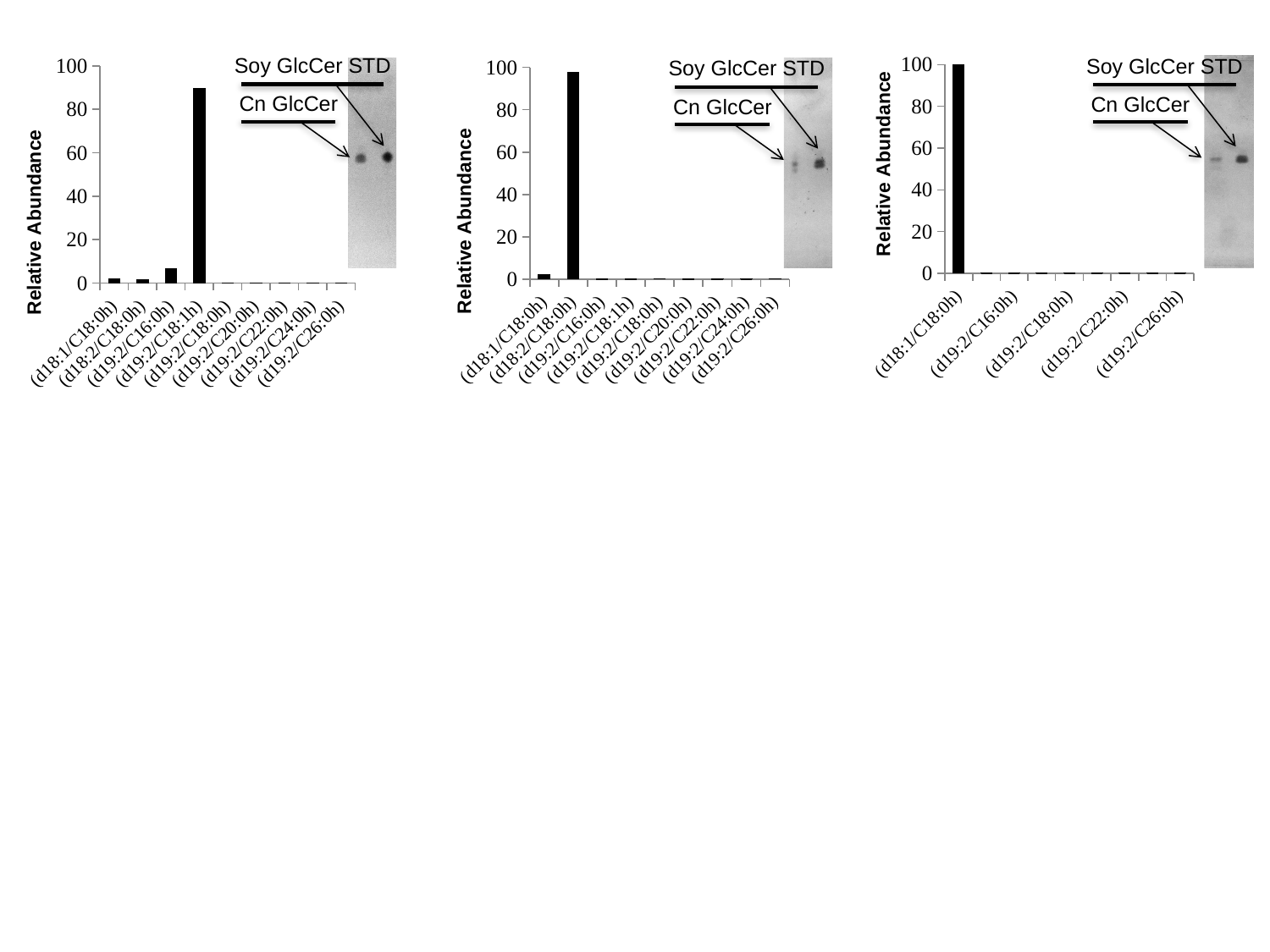
What is the y-axis label of the middle chart? Relative Abundance In the left chart, which category has the highest relative abundance? (d19:2/C18:1h) In the left chart, is the value for (d19:2/C16:0h) greater or less than 20? less In the right chart, which category has the highest relative abundance? (d18:1/C18:0h) In the middle chart, is the value for (d18:2/C18:0h) greater or less than 80? greater In the left chart, is the value for (d19:2/C18:1h) greater or less than 80? greater In the left chart, which is larger, the value for (d19:2/C16:0h) or the value for (d18:1/C18:0h)? (d19:2/C16:0h) What kind of chart is the left chart on the slide? bar chart How many categories are shown on the x axis of the left chart? 9 In the middle chart, which category has the highest relative abundance? (d18:2/C18:0h) What are the two labels annotating the image inset in the right chart? Soy GlcCer STD and Cn GlcCer